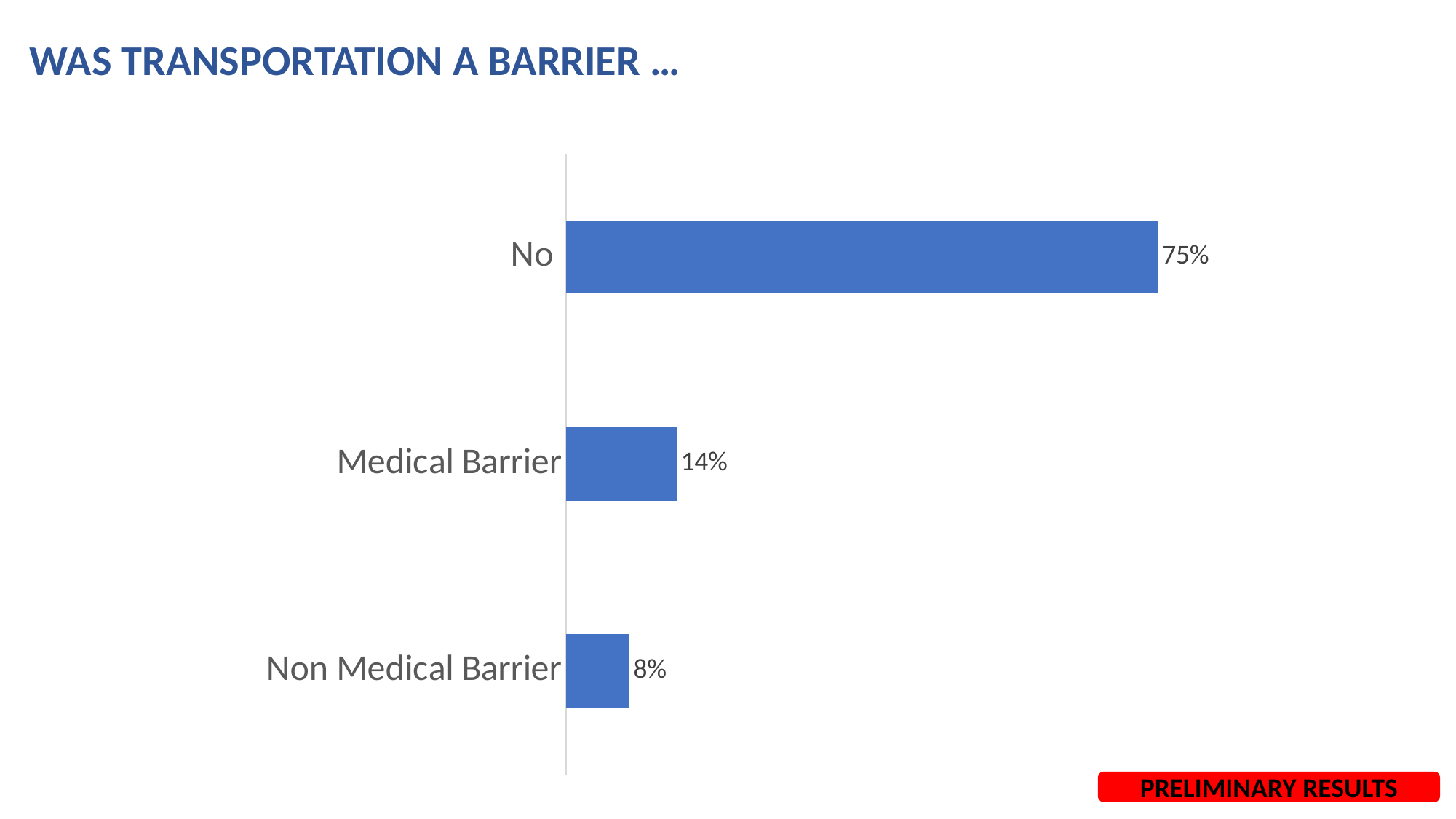
What colour are the bars in the chart? Blue Which is larger, the value for "Medical Barrier" or for "Non Medical Barrier"? Medical Barrier Which category has the lowest value? Non Medical Barrier How many categories are shown in the chart? 3 What percentage is shown for "Non Medical Barrier"? 8% Which category has the highest value? No What percentage is shown for the "No" category? 75% What is the difference between the "No" value and the "Medical Barrier" value? 61% What is the difference between the "Medical Barrier" and "Non Medical Barrier" values? 6% What kind of chart is shown on the slide? Bar chart What percentage is shown for "Medical Barrier"? 14% What is the title of the slide? WAS TRANSPORTATION A BARRIER ...